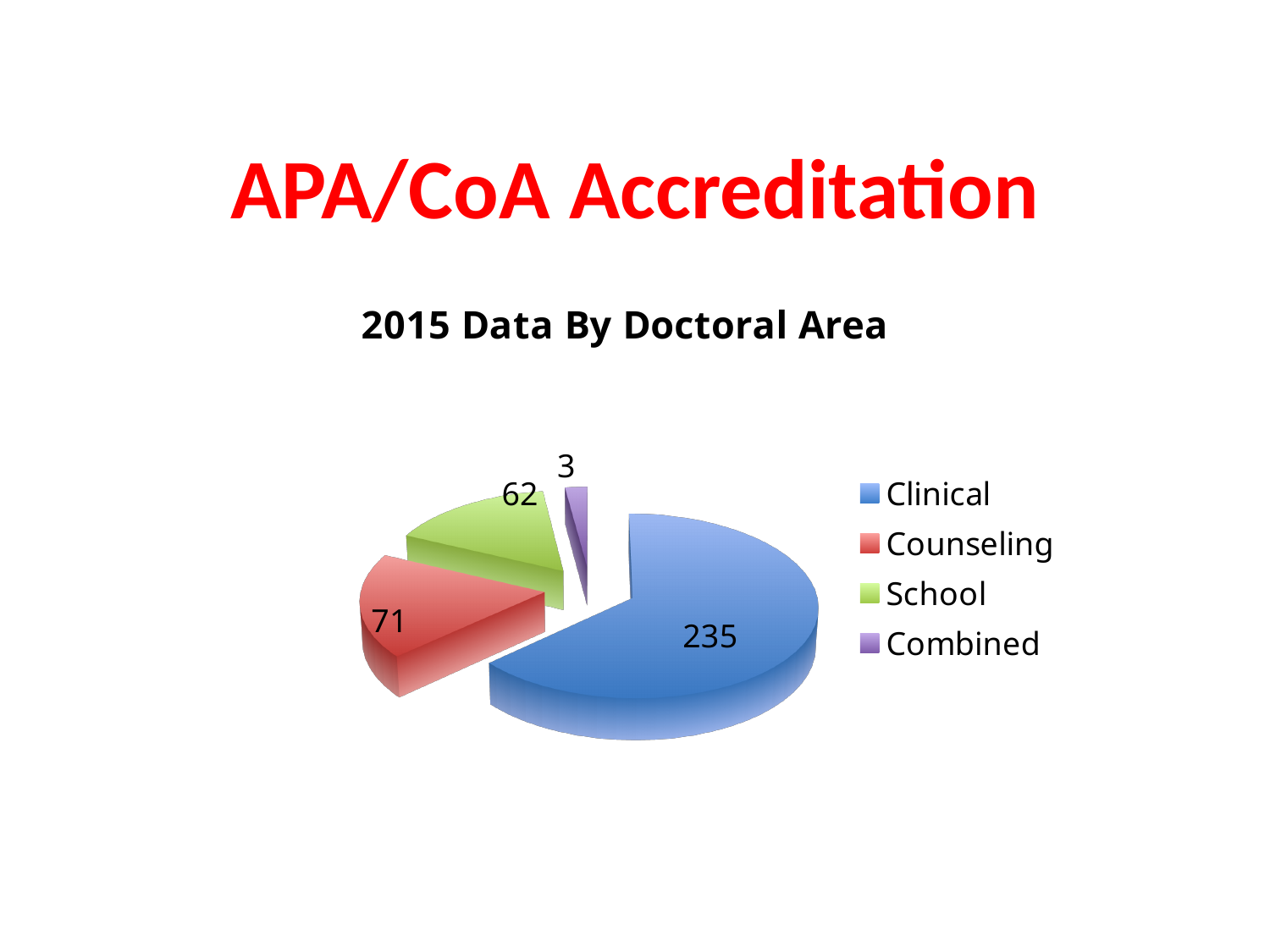
What is the difference between the Clinical and Counseling values? 164 What is the value for Counseling in the pie chart? 71 What is the difference between the Counseling and School values? 9 Which doctoral area has the smallest slice of the pie chart? Combined What is the subtitle shown above the pie chart? 2015 Data By Doctoral Area What is the value for Clinical in the pie chart? 235 Which doctoral area has the largest slice of the pie chart? Clinical What is the value for Combined in the pie chart? 3 Which is larger, the value for Counseling or the value for School? Counseling What is the value for School in the pie chart? 62 How many categories does the pie chart show? 4 What type of chart is shown on the slide? Pie chart